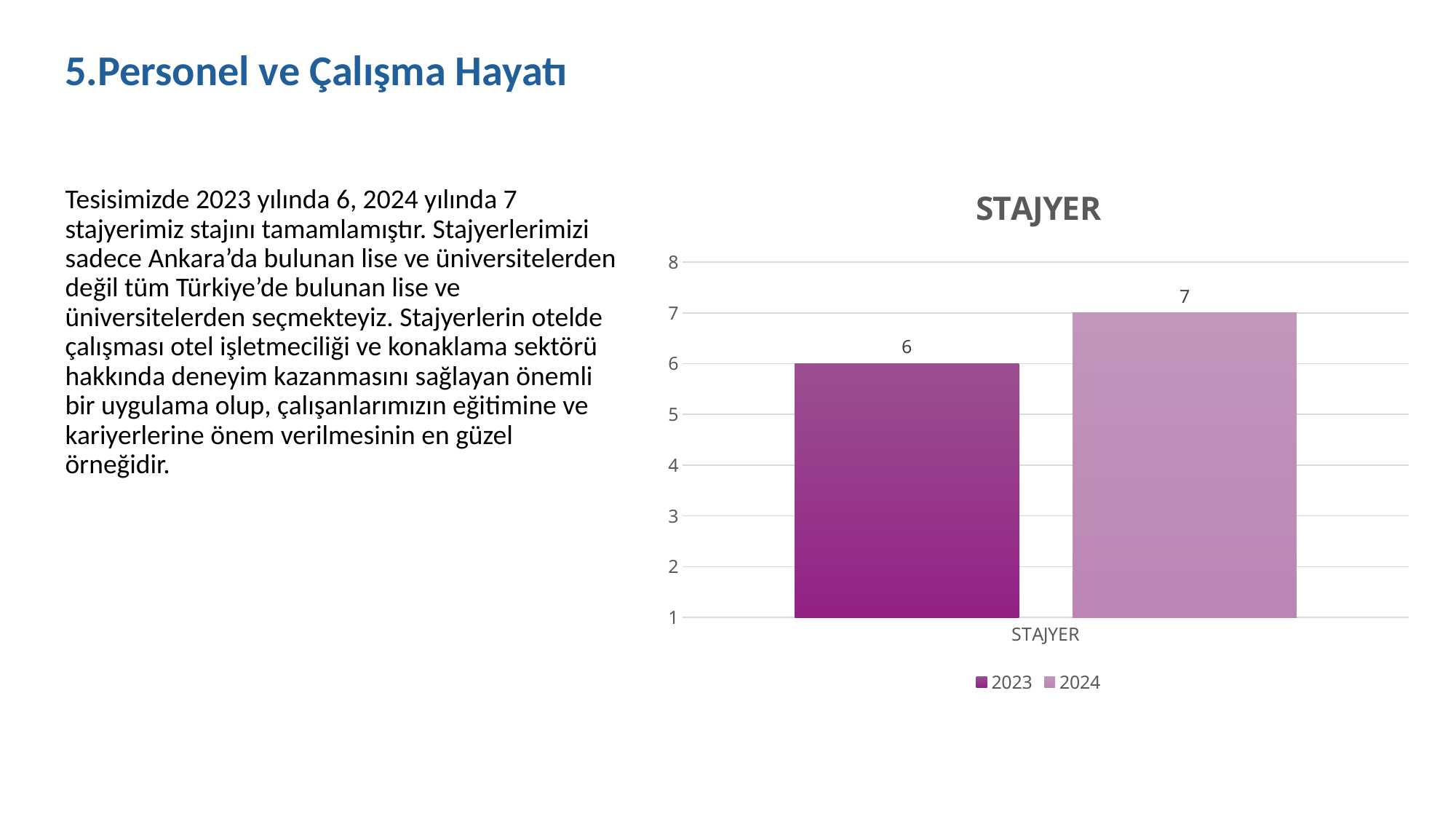
How many categories are shown on the x axis of the STAJYER chart? 1 What kind of chart is shown on the slide? Bar chart Is the value for 2024 in the STAJYER chart greater or less than 5? greater How many series does the legend of the STAJYER chart list? 2 Which series has the lowest value in the STAJYER chart? 2023 Which series has the higher value in the STAJYER chart, 2023 or 2024? 2024 What is the value for 2024 in the STAJYER chart? 7 What are the two series listed in the legend of the STAJYER chart? 2023 and 2024 What is the difference between the 2024 and 2023 values in the STAJYER chart? 1 What is the value for 2023 in the STAJYER chart? 6 What is the title of the chart on the slide? STAJYER